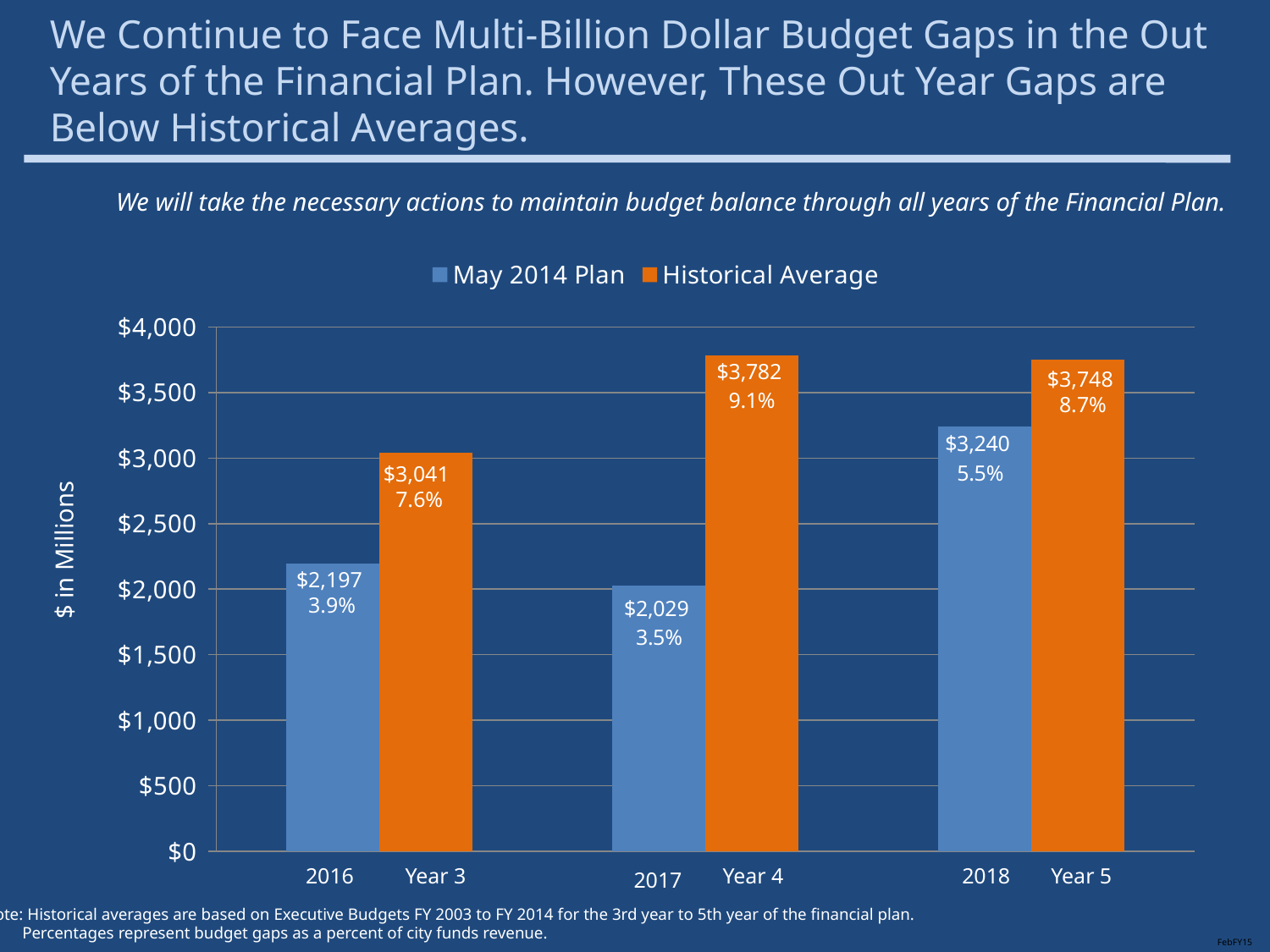
What is the unit shown on the vertical axis label? $ in Millions What percentage of city funds revenue does the May 2014 Plan gap for 2018 represent? 5.5% Is the May 2014 Plan value for 2017 greater or less than $2,500? less Which colour represents the Historical Average series? orange What is the difference between the Historical Average for Year 3 and the May 2014 Plan value for 2016? $844 Which year has the highest May 2014 Plan budget gap? 2018 What kind of chart is shown on the slide? bar chart Which year has the lowest May 2014 Plan budget gap? 2017 What is the Historical Average value for Year 4? $3,782 Which is larger, the May 2014 Plan value for 2018 or the Historical Average for Year 5? Historical Average for Year 5 How many series does the legend list? 2 What is the May 2014 Plan budget gap for 2016? $2,197